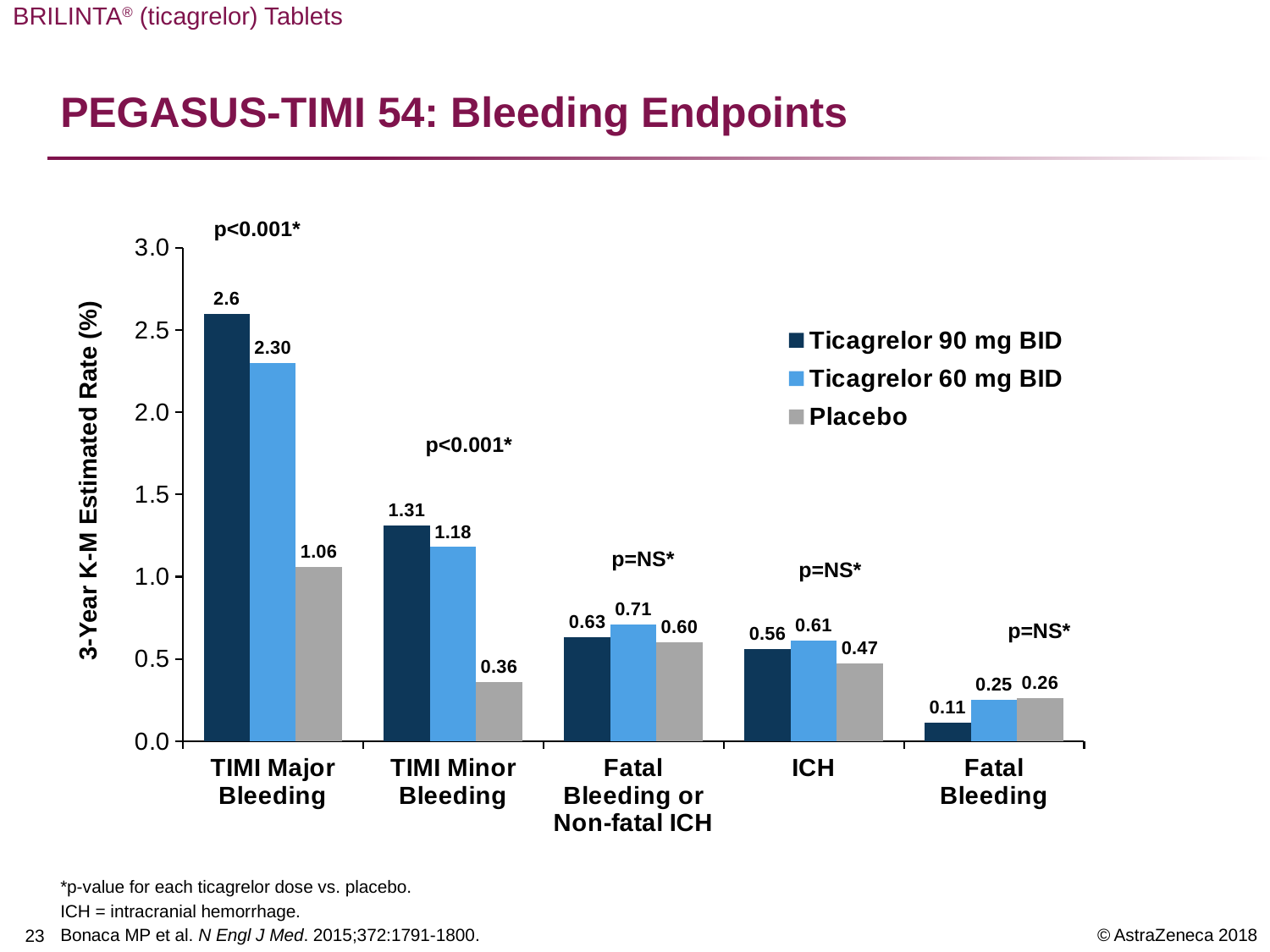
What is the Placebo value for TIMI Minor Bleeding? 0.36 What kind of chart is shown on the slide? Bar chart For ICH, which is larger: the Ticagrelor 60 mg BID value or the Placebo value? Ticagrelor 60 mg BID What is the difference between the Ticagrelor 90 mg BID and Placebo values for TIMI Major Bleeding? 1.54 What is the Ticagrelor 60 mg BID value for Fatal Bleeding or Non-fatal ICH? 0.71 What p-value is shown above the TIMI Minor Bleeding bars? p<0.001* How many series does the legend list? 3 How many bleeding endpoints are shown on the x axis? 5 Which endpoint has the highest value for Ticagrelor 90 mg BID? TIMI Major Bleeding What is the Placebo value for ICH? 0.47 Which endpoint has the lowest value for Ticagrelor 90 mg BID? Fatal Bleeding What is the 3-year K-M estimated rate for Ticagrelor 90 mg BID for TIMI Major Bleeding? 2.6